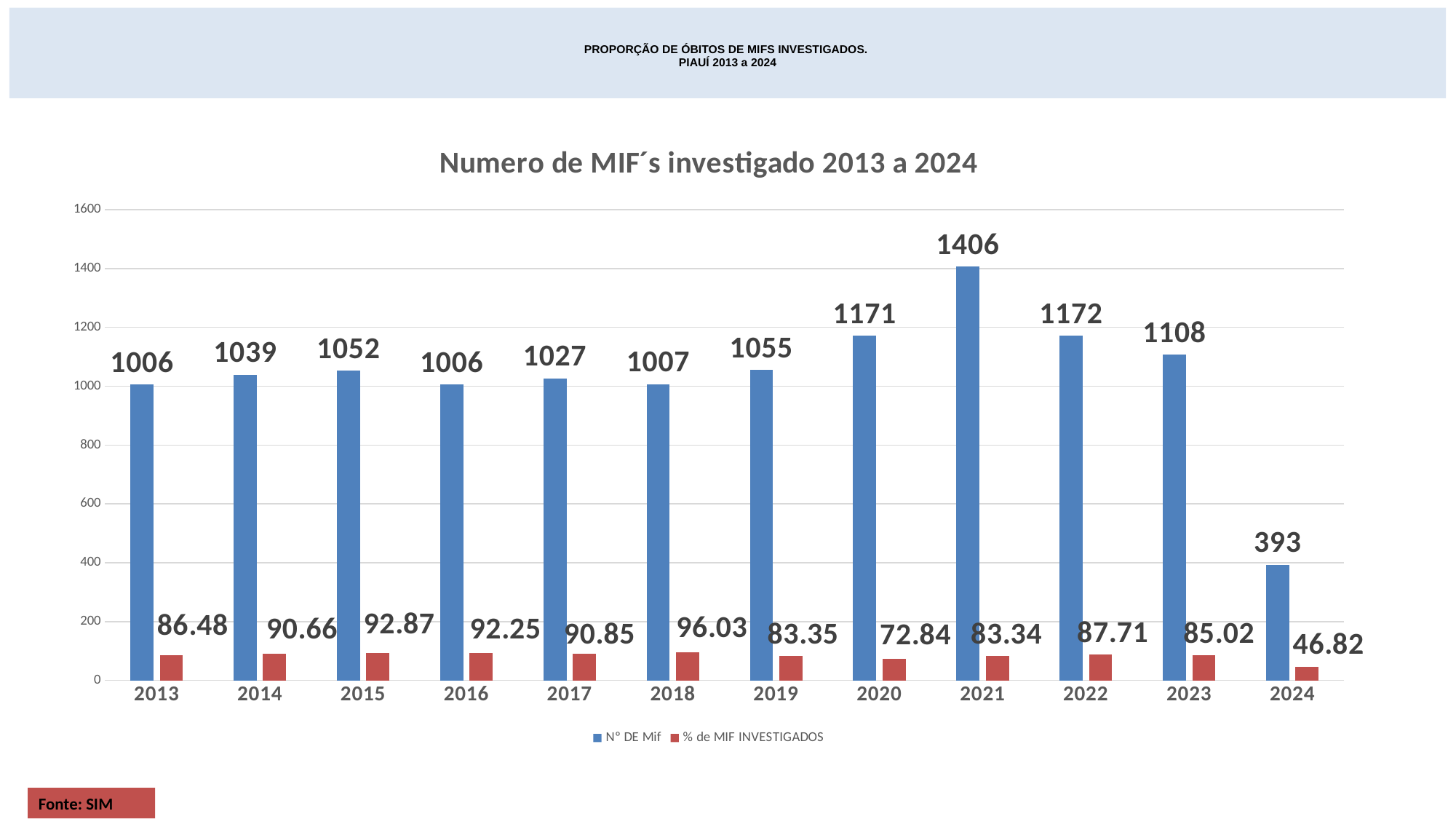
How many years are shown on the x axis? 12 What is the % de MIF INVESTIGADOS value for 2018? 96.03 What is the value of N° DE Mif for 2021? 1406 What is the title of the chart? Numero de MIF´s investigado 2013 a 2024 What is the N° DE Mif value for 2024? 393 Is the N° DE Mif value for 2023 greater or less than 1000? greater How many series does the legend list? 2 What kind of chart is shown on the slide? Bar chart Which year has the highest N° DE Mif? 2021 Which year has the lowest % de MIF INVESTIGADOS? 2024 Which year has the larger N° DE Mif, 2015 or 2019? 2019 What is the difference in N° DE Mif between 2021 and 2020? 235